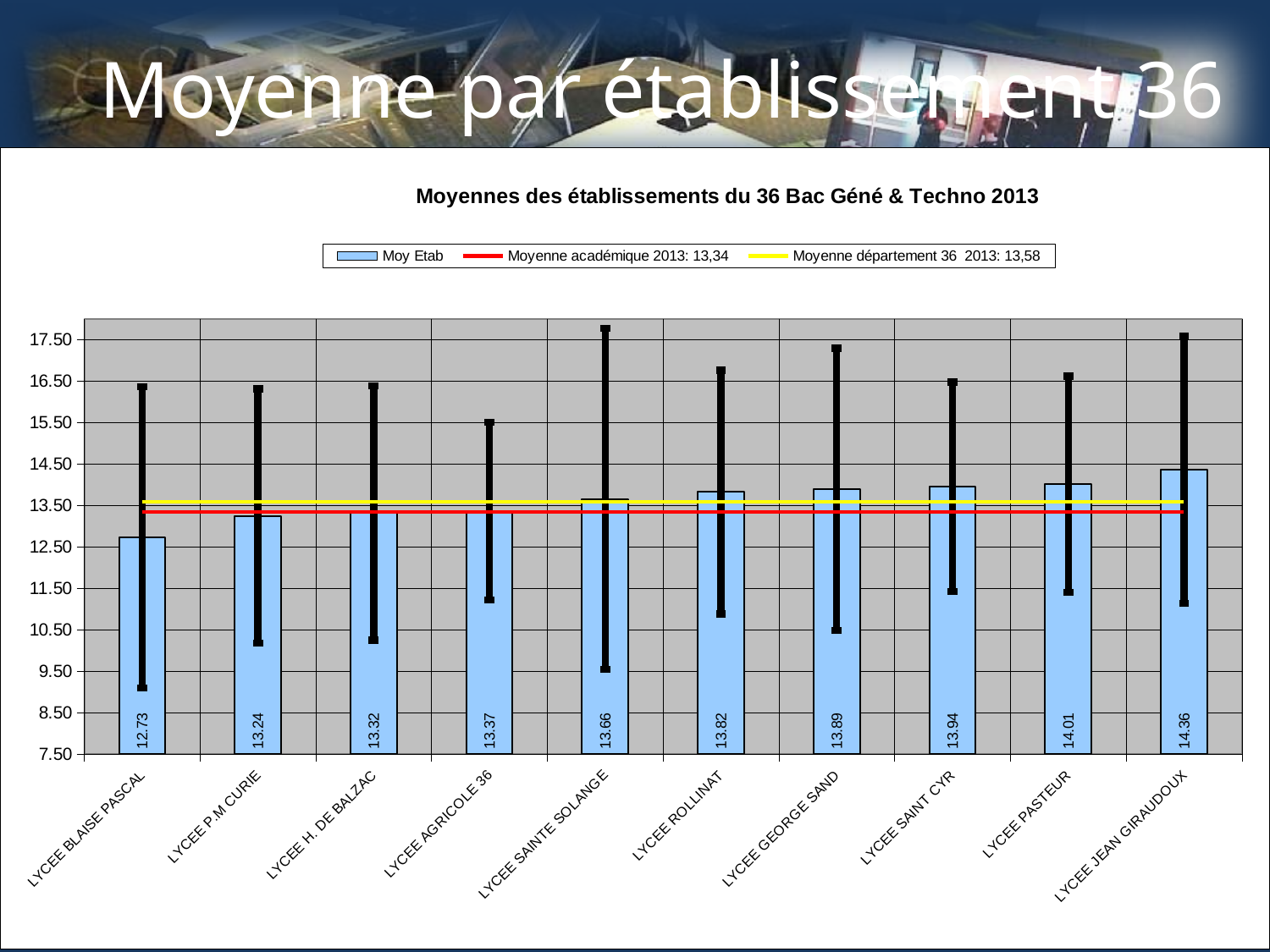
How many establishments are shown on the x axis? 10 Do the bar values rise or fall from left to right along the x axis? rise Which establishment has the highest value? LYCEE JEAN GIRAUDOUX What kind of chart is this? bar chart What is the title of the chart? Moyennes des établissements du 36 Bac Géné & Techno 2013 How many entries does the legend list? 3 Which is larger, the value for LYCEE PASTEUR or the value for LYCEE GEORGE SAND? LYCEE PASTEUR What is the value for LYCEE BLAISE PASCAL? 12.73 What is the value for LYCEE SAINT CYR? 13.94 What is the value for LYCEE ROLLINAT? 13.82 Which establishment has the lowest value? LYCEE BLAISE PASCAL What is the difference between the values for LYCEE JEAN GIRAUDOUX and LYCEE BLAISE PASCAL? 1.63